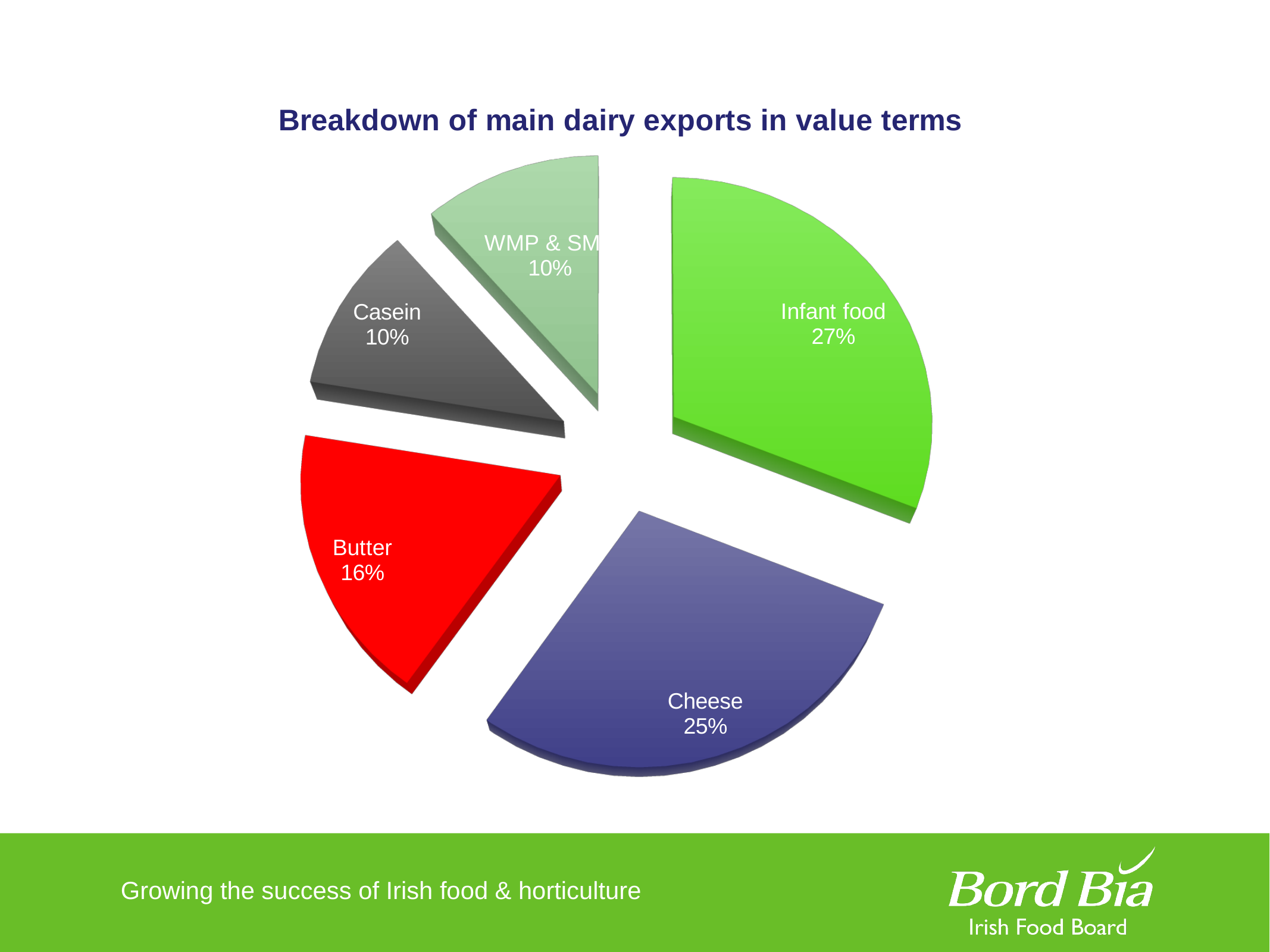
What kind of chart is shown on the slide? pie chart What is the title of the chart? Breakdown of main dairy exports in value terms How many slices does the pie chart have? 5 How many percentage points larger is Infant food than Cheese? 2 percentage points Which category has the largest share of the pie? Infant food What percentage is shown for Casein? 10% What share of main dairy exports in value terms is Infant food? 27% What is the difference between the Cheese share and the Butter share? 9 percentage points What is the value shown for Butter? 16% What percentage does the Cheese slice represent? 25% Which is larger, Infant food or Cheese? Infant food Which is larger, the Butter share or the Casein share? Butter